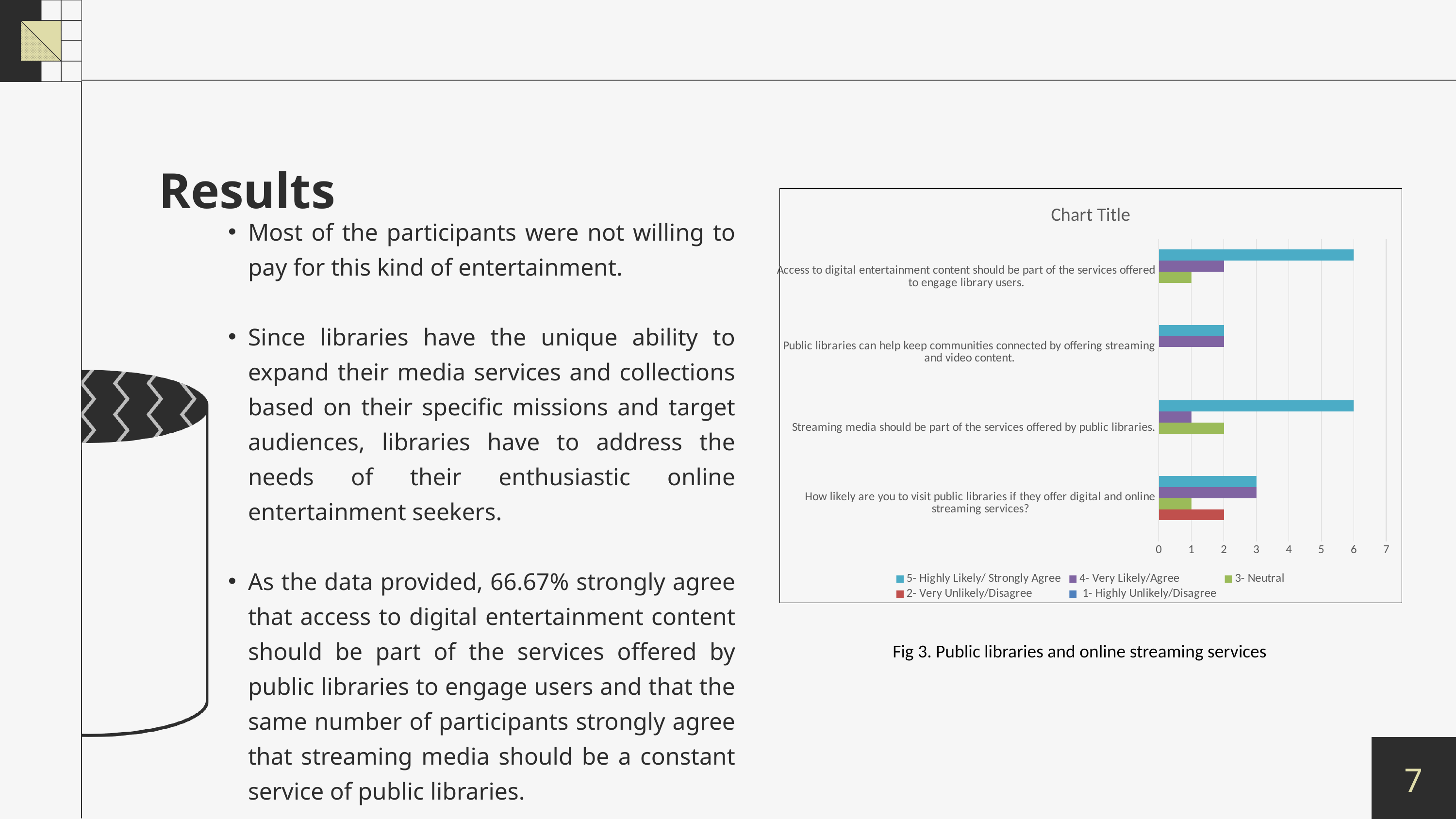
What is the value of '2- Very Unlikely/Disagree' for 'How likely are you to visit public libraries if they offer digital and online streaming services?'? 2 What is the value of '5- Highly Likely/ Strongly Agree' for 'Streaming media should be part of the services offered by public libraries.'? 6 Which category has the lowest value for '5- Highly Likely/ Strongly Agree'? Public libraries can help keep communities connected by offering streaming and video content. What is the difference between the '5- Highly Likely/ Strongly Agree' value and the '4- Very Likely/Agree' value for 'Access to digital entertainment content should be part of the services offered to engage library users.'? 4 What kind of chart is shown on the slide? bar chart What is the value of '5- Highly Likely/ Strongly Agree' for 'Access to digital entertainment content should be part of the services offered to engage library users.'? 6 How many categories (survey statements) are shown on the chart? 4 What is the figure caption shown below the chart? Fig 3. Public libraries and online streaming services For 'Streaming media should be part of the services offered by public libraries.', which is larger: the '3- Neutral' value or the '4- Very Likely/Agree' value? 3- Neutral How many series does the chart legend list? 5 Is the '5- Highly Likely/ Strongly Agree' value for 'Streaming media should be part of the services offered by public libraries.' greater or less than 4? greater What is the value of '4- Very Likely/Agree' for 'How likely are you to visit public libraries if they offer digital and online streaming services?'? 3